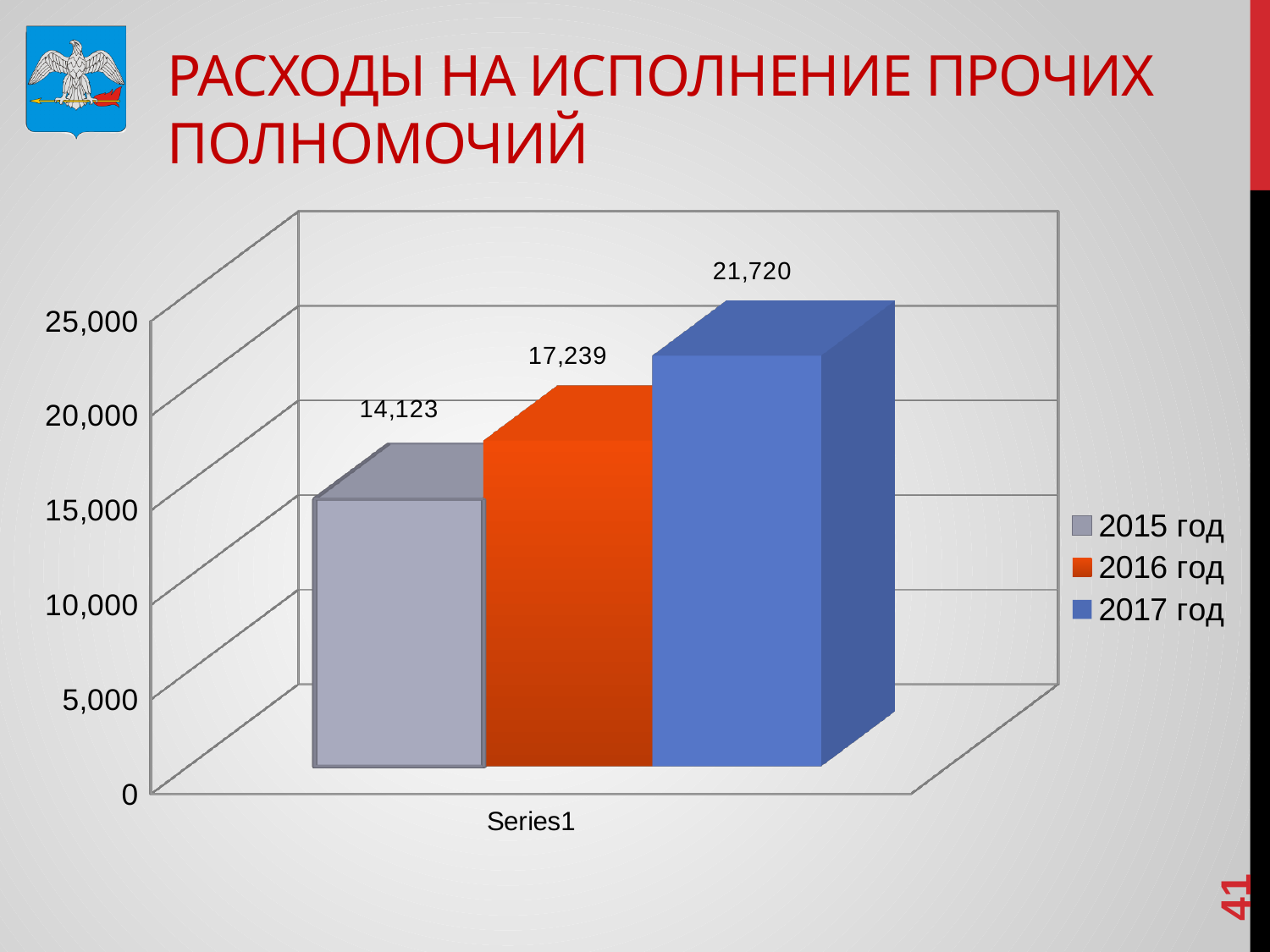
What is the difference between the values for 2017 год and 2015 год? 7,597 What kind of chart is shown on the slide? bar chart Which year has the lowest value? 2015 год Which year has the highest value? 2017 год Is the value for 2017 год greater or less than 20,000? greater What colour is the bar for 2016 год? red What is the difference between the values for 2016 год and 2015 год? 3,116 What is the value for 2016 год? 17,239 How many series does the legend list? 3 What is the value for 2017 год? 21,720 What is the value for 2015 год? 14,123 Which is larger, the value for 2016 год or the value for 2017 год? 2017 год